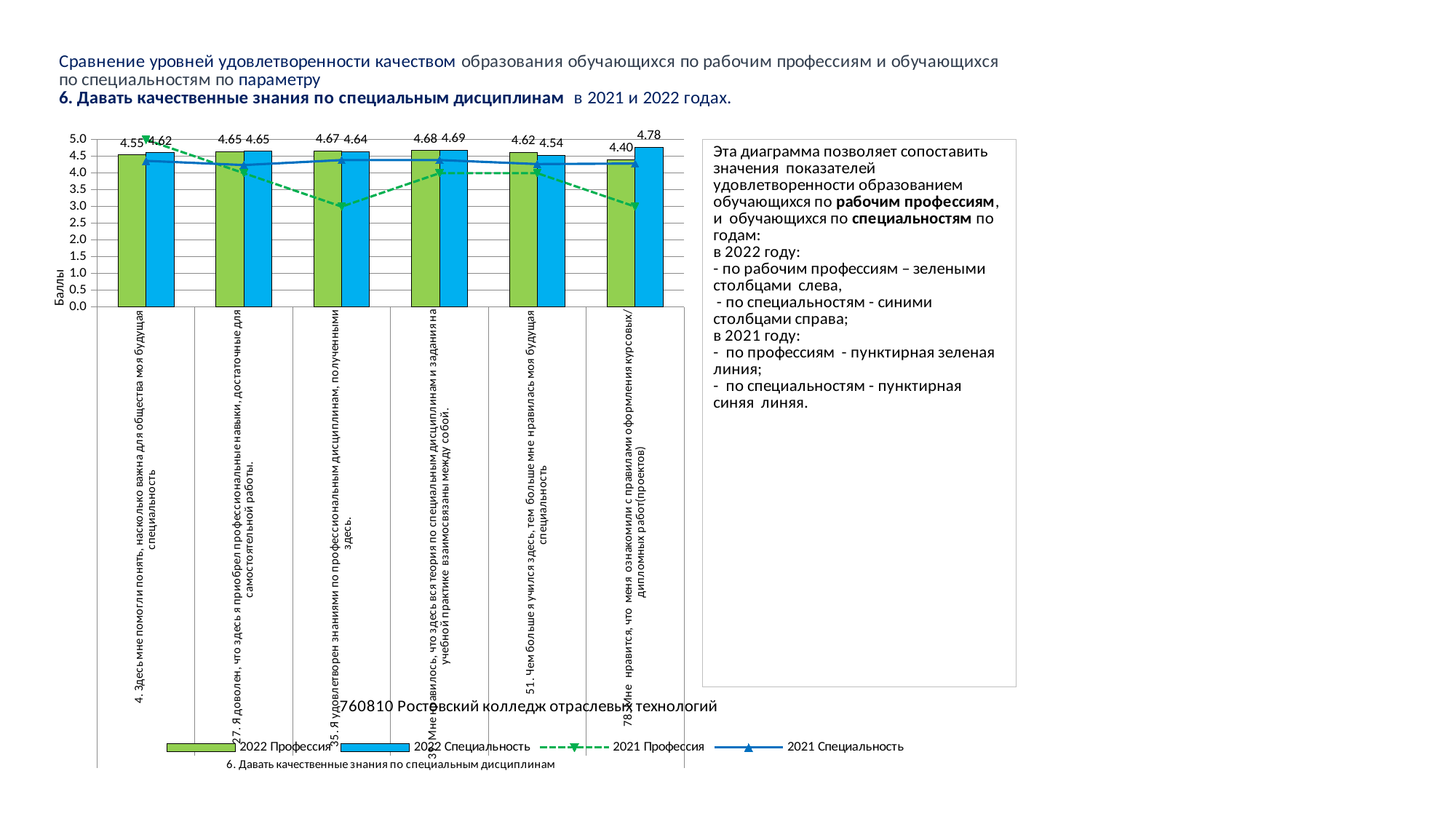
Which category has the highest 2022 Специальность value? 78. Мне нравится, что меня ознакомили с правилами оформления курсовых/дипломных работ(проектов) For category 51, which is larger: the 2022 Профессия value or the 2022 Специальность value? 2022 Профессия What is the value of the 2022 Профессия bar for category 78 (Мне нравится, что меня ознакомили с правилами оформления курсовых/дипломных работ)? 4.40 How many categories are shown on the x axis of the chart? 6 What is the value of the 2022 Специальность bar for category 78 (Мне нравится, что меня ознакомили с правилами оформления курсовых/дипломных работ)? 4.78 What is the value of the 2022 Профессия bar for category 4 (Здесь мне помогли понять, насколько важна для общества моя будущая специальность)? 4.55 What is the difference between the 2022 Специальность and 2022 Профессия values for category 78? 0.38 Which category has the lowest 2022 Профессия value? 78. Мне нравится, что меня ознакомили с правилами оформления курсовых/дипломных работ(проектов) What is the title of the vertical axis of the chart? Баллы Is the 2021 Профессия line value for category 35 greater or less than 4.0? less How many series does the chart legend list? 4 What is the value of the 2022 Специальность bar for category 51 (Чем больше я учился здесь, тем больше мне нравилась моя будущая специальность)? 4.54